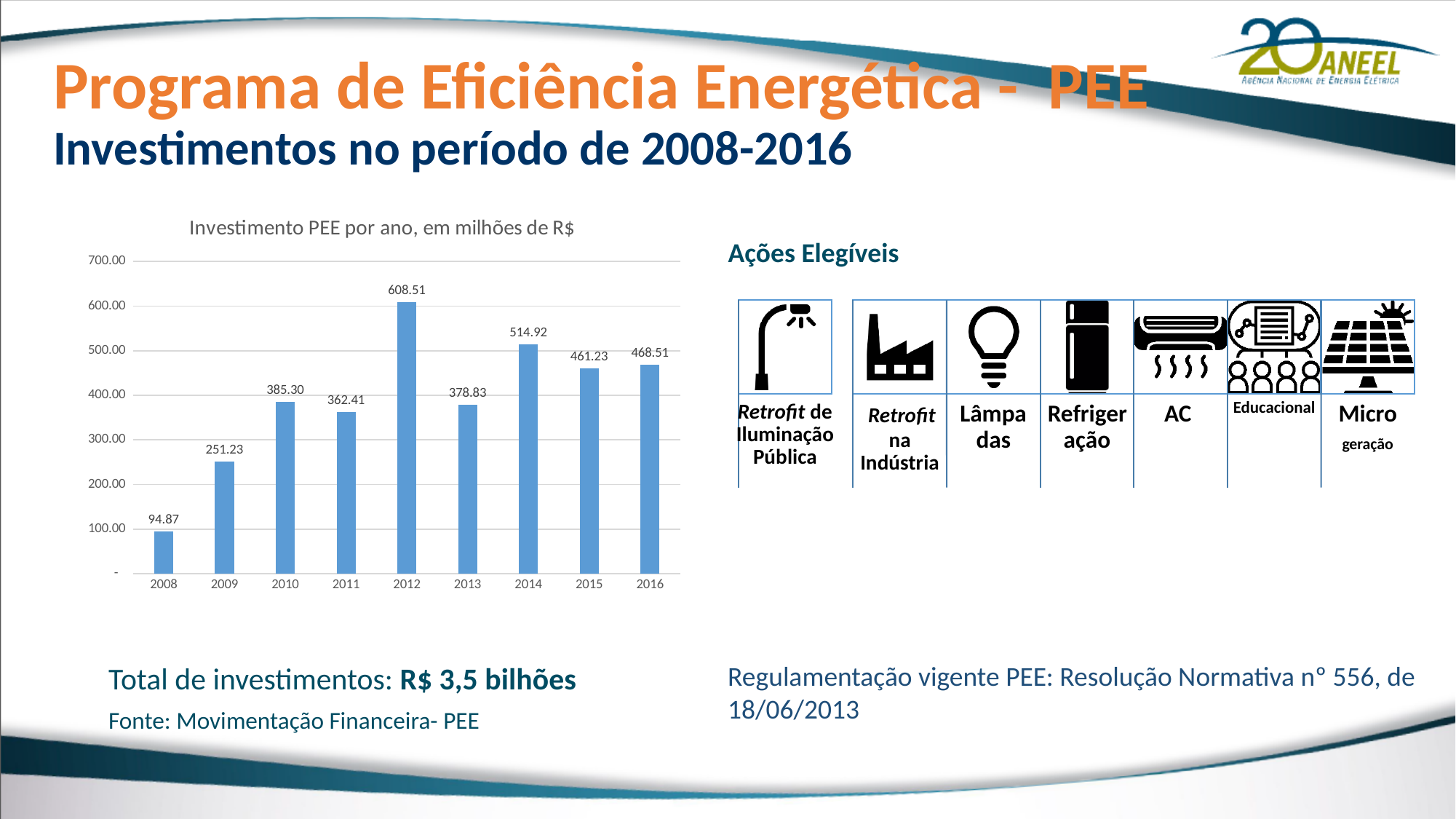
What is the investment value for 2008? 94.87 Which year has the lowest investment value? 2008 What is the investment value for 2012? 608.51 Which year has a larger value, 2010 or 2011? 2010 How many years are shown on the x axis of the chart? 9 Which year has the highest investment value? 2012 What type of chart is shown on the slide? bar chart Is the value for 2013 greater or less than 400? less What is the difference between the values for 2012 and 2014? 93.59 What is the title of the chart? Investimento PEE por ano, em milhões de R$ Do the values rise or fall from 2008 to 2010? rise What is the investment value for 2015? 461.23